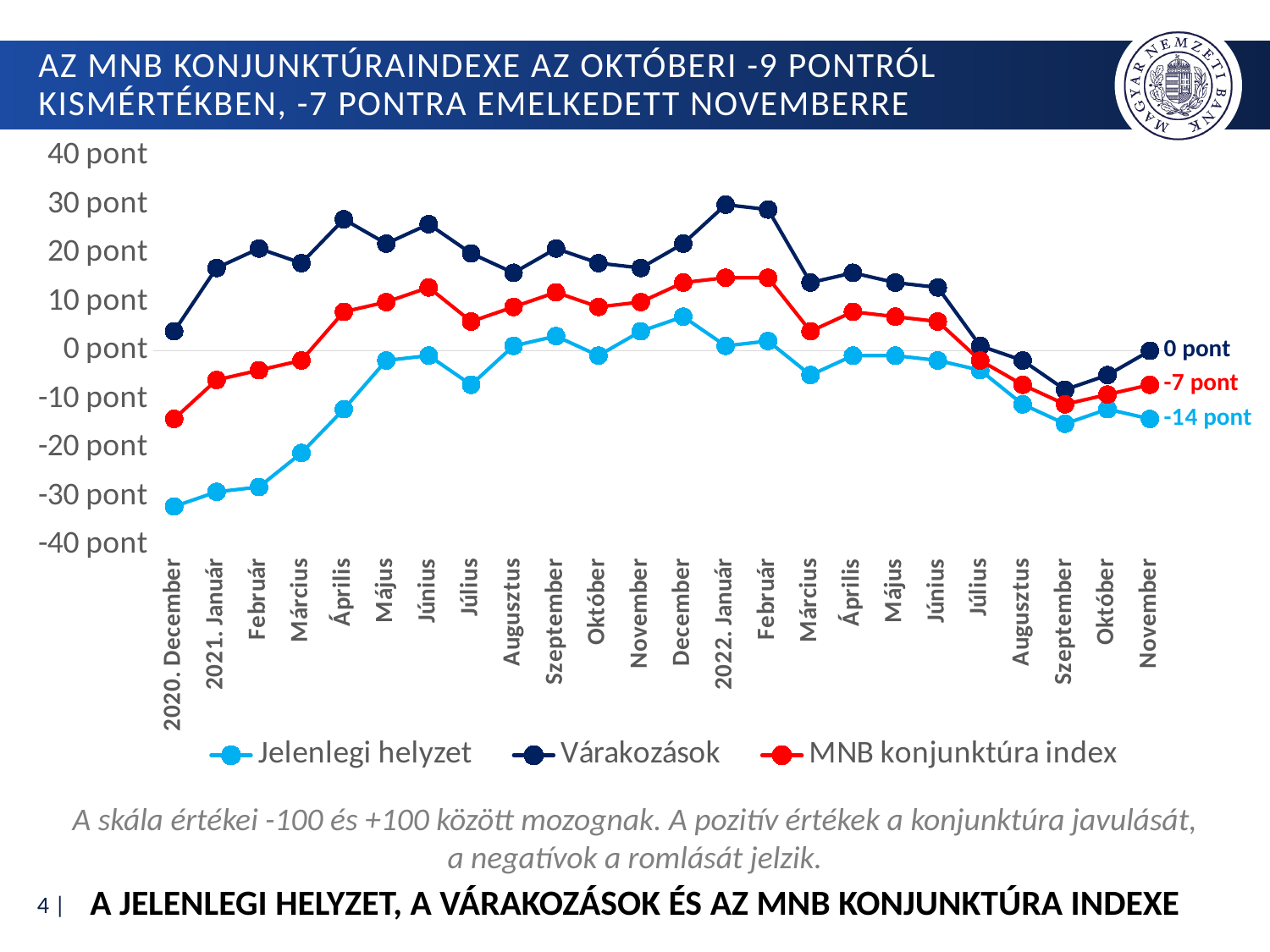
Which series has the highest value in November 2022? Várakozások What is the value of Jelenlegi helyzet in November 2022? -14 pont How many series does the legend list? 3 Is the value of Várakozások in 2022. Január greater or less than 20 pont? greater What kind of chart is shown on the slide? line chart What is the difference between Várakozások and the MNB konjunktúra index in November 2022? 7 pont How many months are plotted on the x axis? 24 What is the value of the MNB konjunktúra index in November 2022? -7 pont Does the Jelenlegi helyzet series rise or fall from 2020. December to 2021. Május? rise Is the value of Jelenlegi helyzet in 2021. Március greater or less than -10 pont? less What is the value of Várakozások in November 2022? 0 pont In November 2022, which is higher: Várakozások or Jelenlegi helyzet? Várakozások